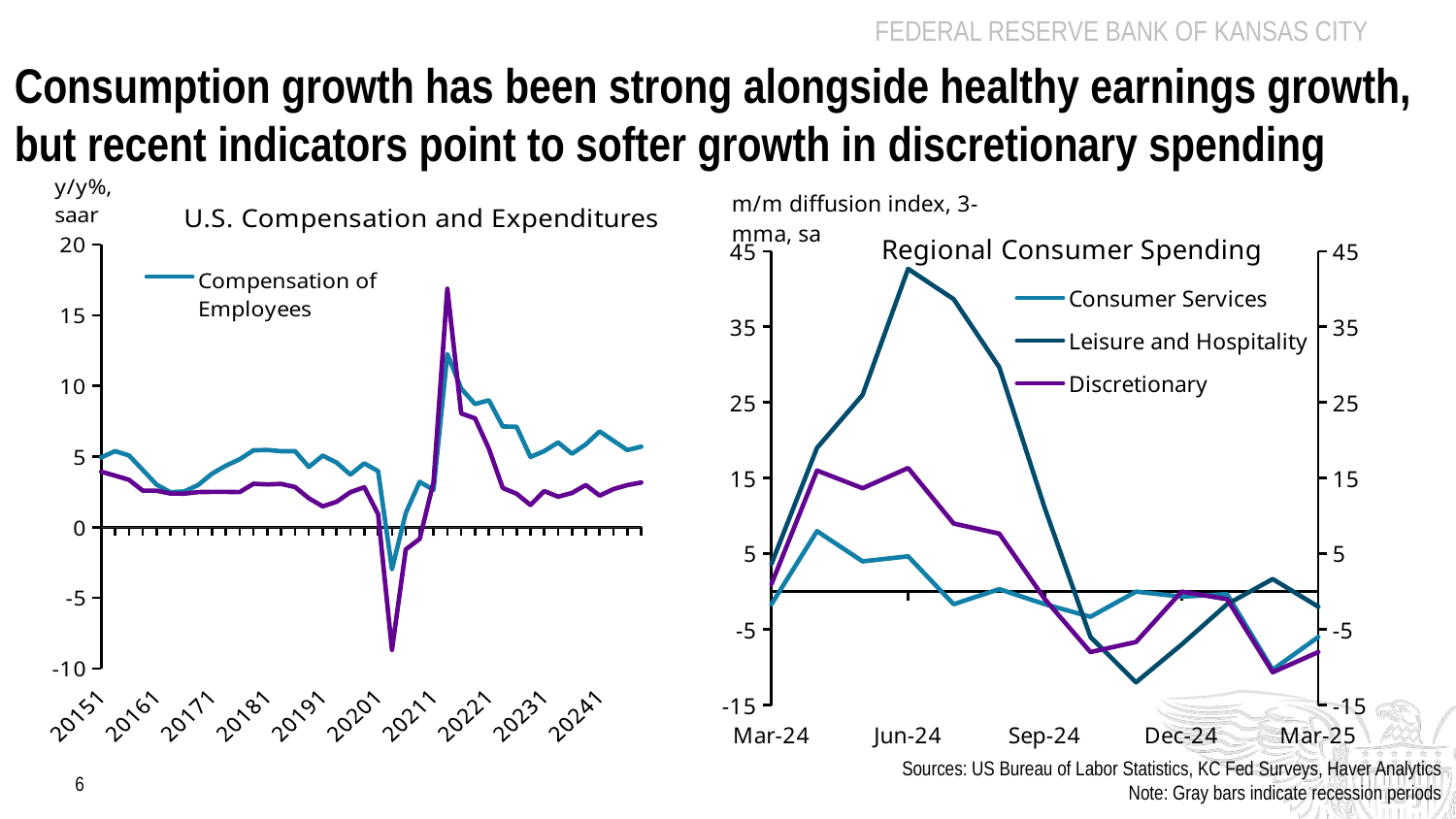
In the 'U.S. Compensation and Expenditures' chart, what is the highest value shown on the y axis? 20 In the 'Regional Consumer Spending' chart, does Leisure and Hospitality rise or fall between Jun-24 and Dec-24? Fall How many series does the legend list in the 'Regional Consumer Spending' chart? 3 In the 'U.S. Compensation and Expenditures' chart, is the peak value of Compensation of Employees around 2021 greater or less than 10? greater In the 'Regional Consumer Spending' chart, which series reaches the highest value? Leisure and Hospitality In the 'U.S. Compensation and Expenditures' chart, is the lowest value of Compensation of Employees around 2020 greater or less than -5? greater In the 'Regional Consumer Spending' chart, is the peak value of Leisure and Hospitality greater or less than 35? greater What kind of chart is the 'U.S. Compensation and Expenditures' chart on the left? Line chart What kind of chart is the 'Regional Consumer Spending' chart on the right? Line chart In the 'Regional Consumer Spending' chart, which series is higher at Jun-24: Leisure and Hospitality or Consumer Services? Leisure and Hospitality